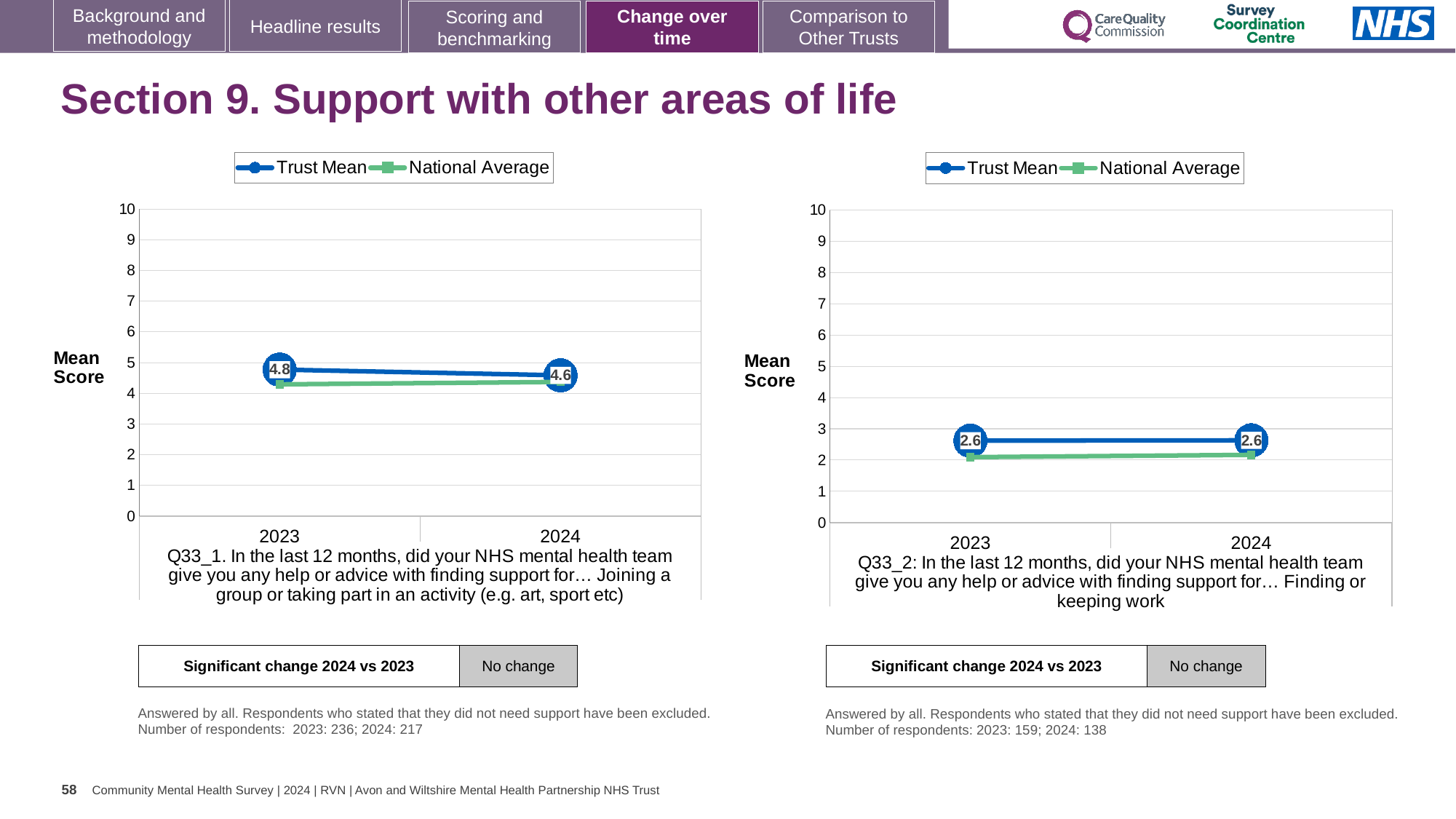
What kind of chart is the left chart (Q33_1)? line chart In the left chart (Q33_1), by how much did the Trust Mean change from 2023 to 2024? decreased by 0.2 What is the y-axis label on the left chart (Q33_1)? Mean Score In the left chart (Q33_1), which is larger for 2023: the Trust Mean or the National Average? Trust Mean In the left chart (Q33_1), does the Trust Mean rise or fall from 2023 to 2024? fall In the right chart (Q33_2), what is the Trust Mean for 2024? 2.6 In the right chart (Q33_2), does the Trust Mean rise, fall or stay the same from 2023 to 2024? stay the same In the left chart (Q33_1), what is the Trust Mean for 2023? 4.8 How many years are shown on the x axis of the left chart (Q33_1)? 2 In the left chart (Q33_1), what is the Trust Mean for 2024? 4.6 In the right chart (Q33_2), is the National Average for 2023 greater or less than 3? less How many series does the legend of the right chart (Q33_2) list? 2